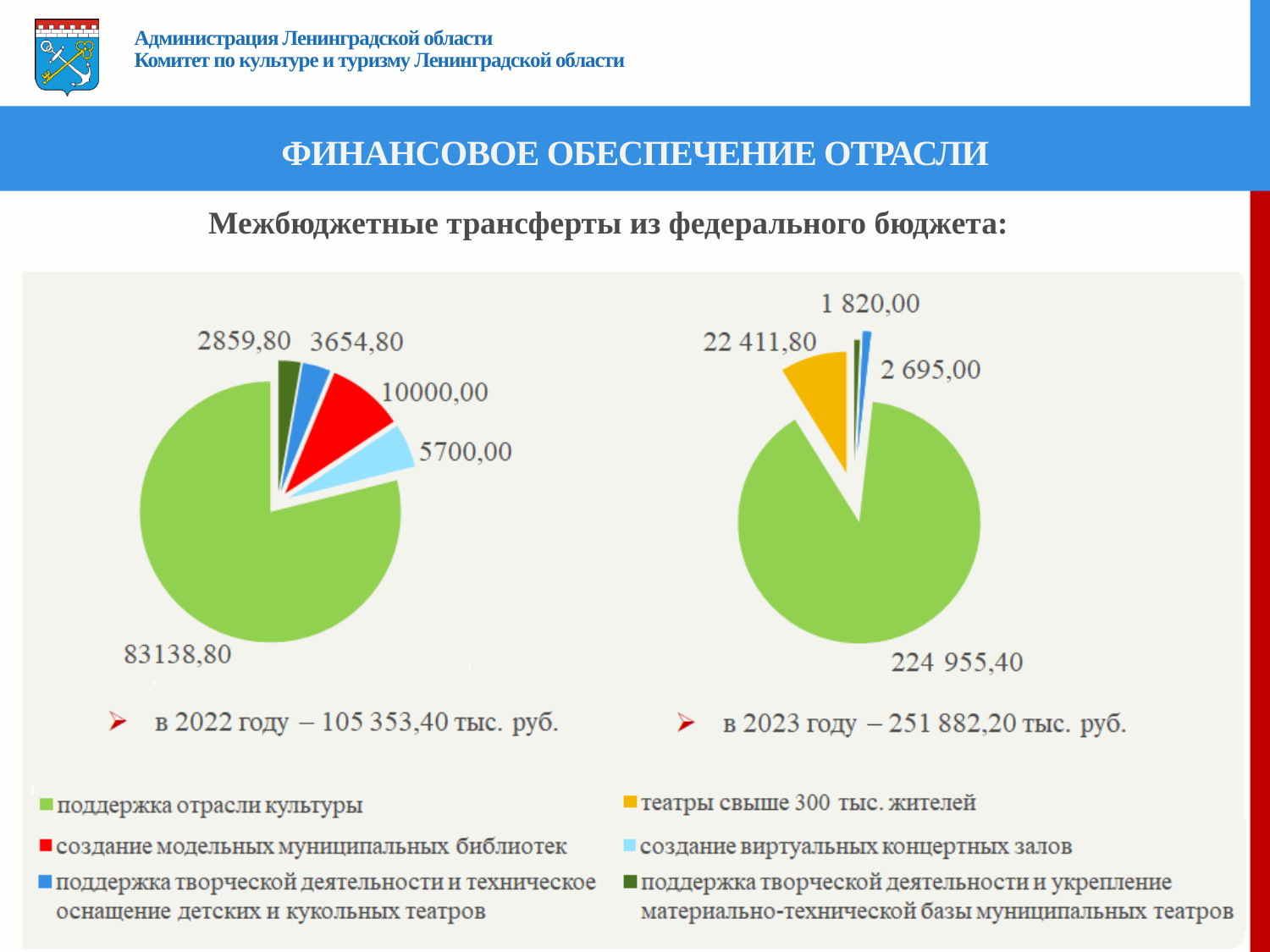
Which is larger: the total federal transfers in 2022 (105 353,40 тыс. руб.) or in 2023 (251 882,20 тыс. руб.)? 2023 In the 2022 pie chart (left), what is the difference between the red slice (10000,00) and the light blue slice (5700,00)? 4300,00 In the 2023 pie chart (right), what is the smallest labelled value? 1 820,00 How many categories does the legend at the bottom of the slide list? 6 In the 2022 pie chart (left), what is the value for создание виртуальных концертных залов (light blue slice)? 5700,00 In the 2023 pie chart (right), what is the value of the largest slice (поддержка отрасли культуры)? 224 955,40 What kind of charts are shown on the slide? Pie charts In the 2023 pie chart (right), what is the value for театры свыше 300 тыс. жителей (yellow slice)? 22 411,80 In the 2022 pie chart (left), what is the value for создание модельных муниципальных библиотек (red slice)? 10000,00 In the 2023 pie chart (right), how many slices are there? 4 In the 2022 pie chart (left), what is the value of the largest slice (поддержка отрасли культуры)? 83138,80 In the 2022 pie chart (left), how many slices are there? 5